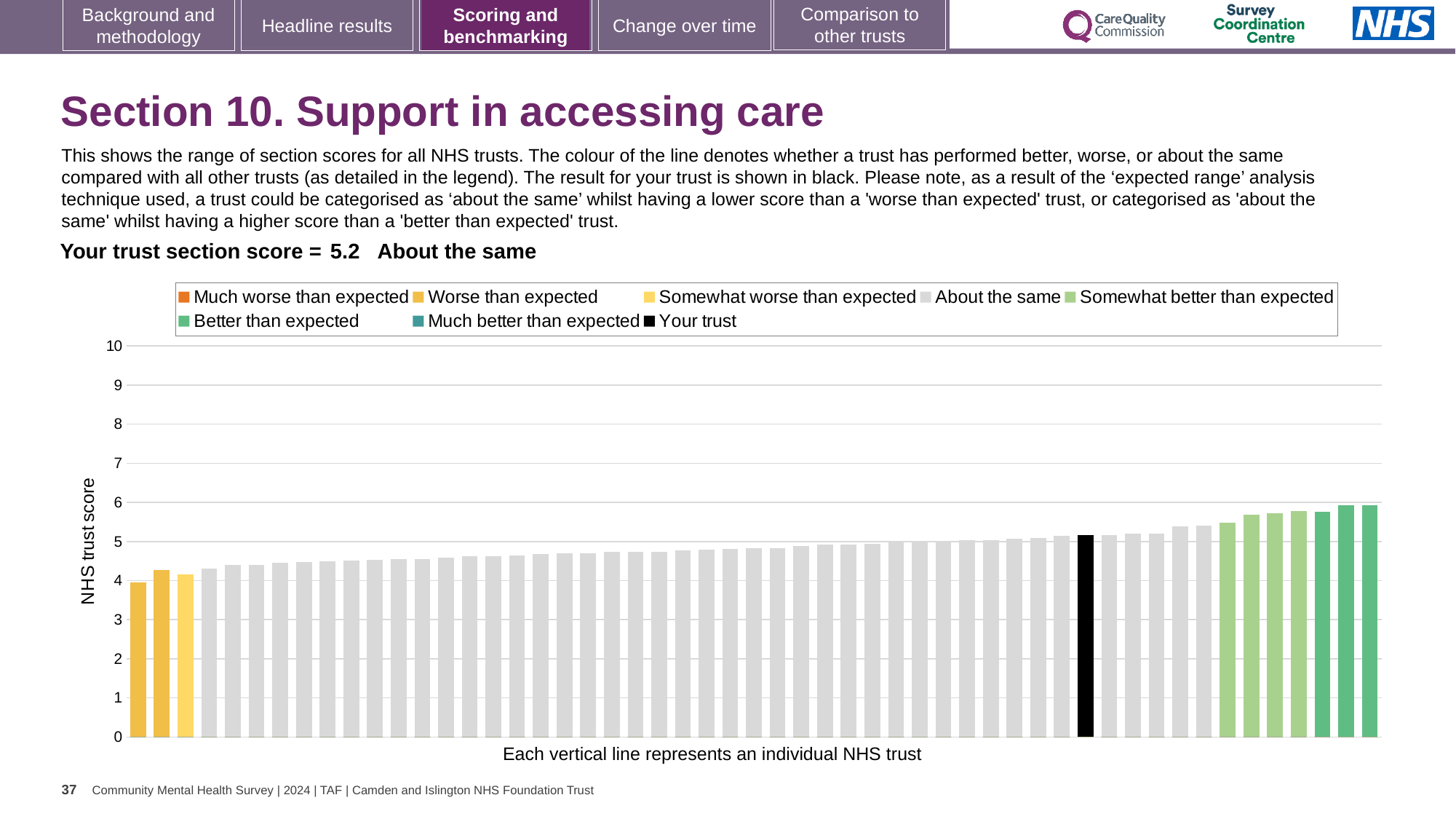
What kind of chart is shown on the slide? bar chart How many bars are coloured in the light green 'Somewhat better than expected' colour? 4 Do the bar values rise or fall from left to right along the x axis? rise What colour is the bar representing your trust? black What is the label on the vertical axis of the chart? NHS trust score What is the section score for your trust shown on the slide? 5.2 How many entries does the chart legend list? 8 How many bars are coloured in the darker green 'Better than expected' colour? 3 Is the value for your trust (the black bar) greater or less than 5? greater How is your trust's score categorised compared with other trusts? About the same Is the value of the lowest bar greater or less than 3? greater